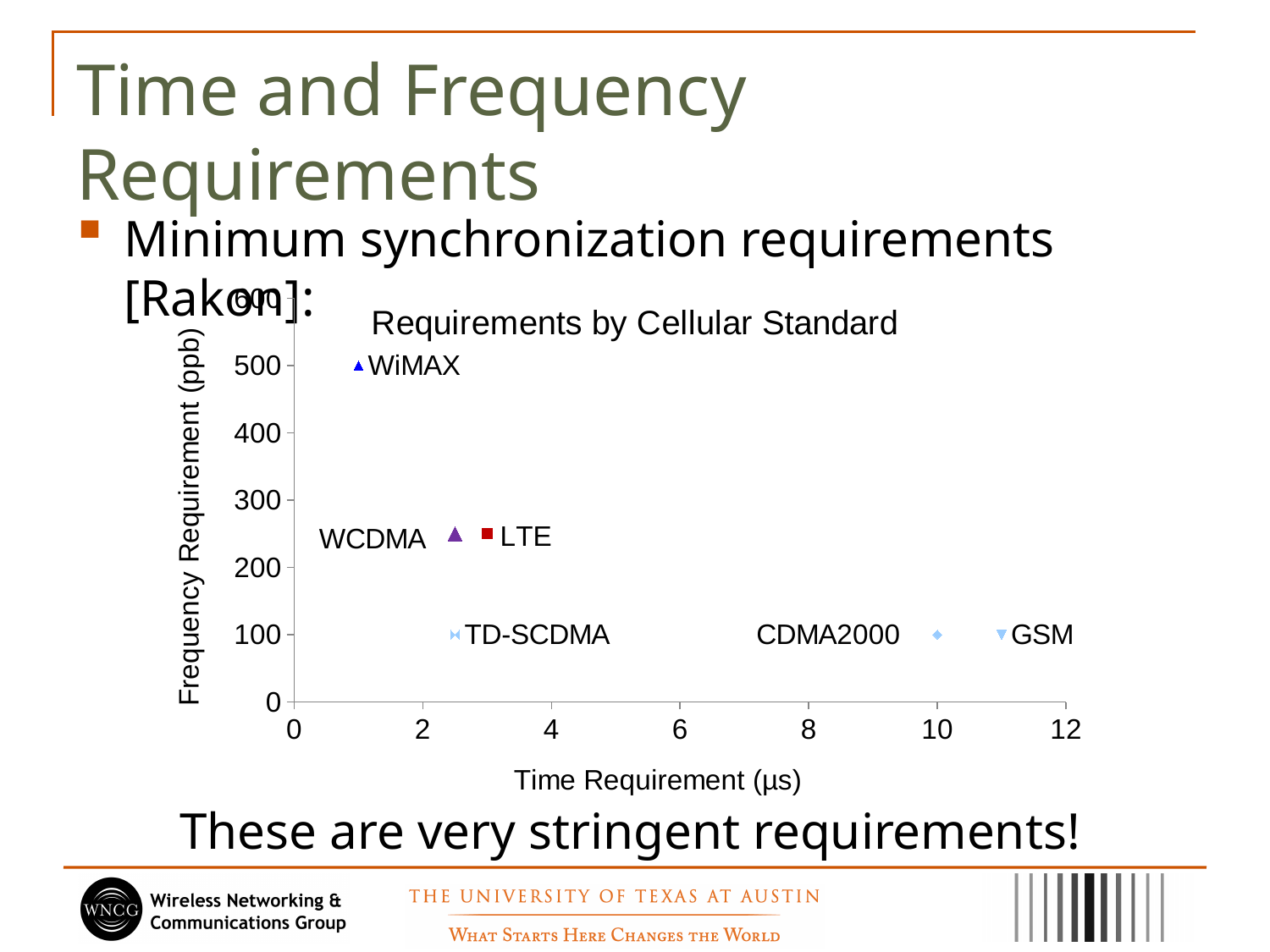
What is the difference between the frequency requirements of WiMAX and GSM? 400 ppb Which has the larger time requirement, GSM or TD-SCDMA? GSM What is the title of the chart? Requirements by Cellular Standard Is the frequency requirement for WCDMA greater or less than 200 ppb? greater Is the time requirement for GSM greater or less than 10 µs? greater How many cellular standards are plotted on the chart? 6 What kind of chart is shown on the slide? scatter chart Which cellular standard has the lowest time requirement? WiMAX Which cellular standard has the highest frequency requirement? WiMAX What is the frequency requirement for GSM? 100 ppb What is the time requirement for CDMA2000? 10 µs What is the frequency requirement for WiMAX? 500 ppb